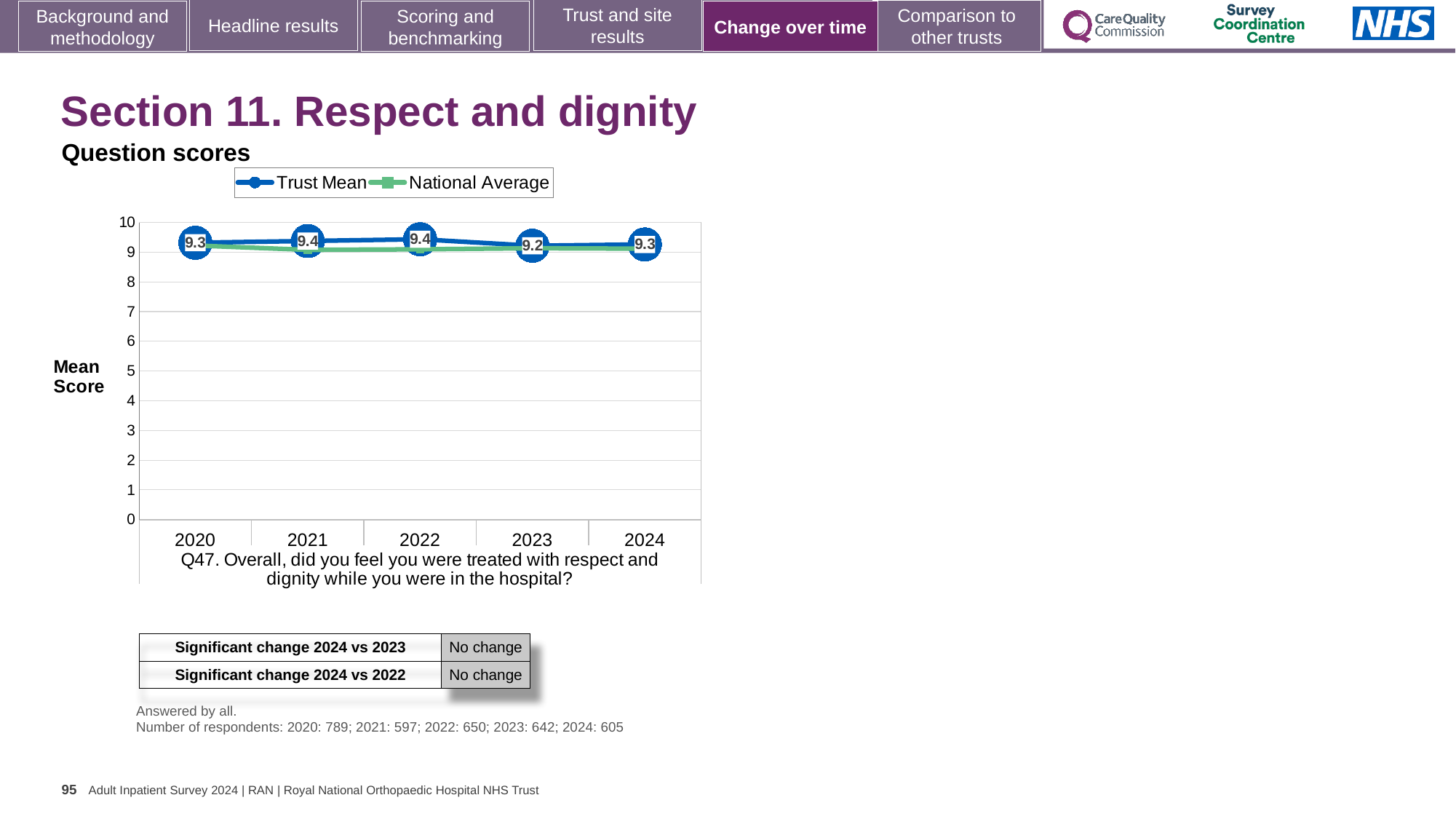
What kind of chart is shown on the slide? Line chart What is the Trust Mean score for 2024? 9.3 Is the National Average value for 2024 greater or less than 8? greater How many years are plotted on the x axis? 5 In which year is the Trust Mean score lowest? 2023 Which year has the larger Trust Mean score, 2022 or 2023? 2022 How many series does the legend list? 2 What is the difference between the Trust Mean scores for 2021 and 2023? 0.2 What is the Trust Mean score for 2021? 9.4 What is the Trust Mean score for 2023? 9.2 What is the Trust Mean score for 2020? 9.3 Does the Trust Mean score rise or fall from 2022 to 2023? Fall